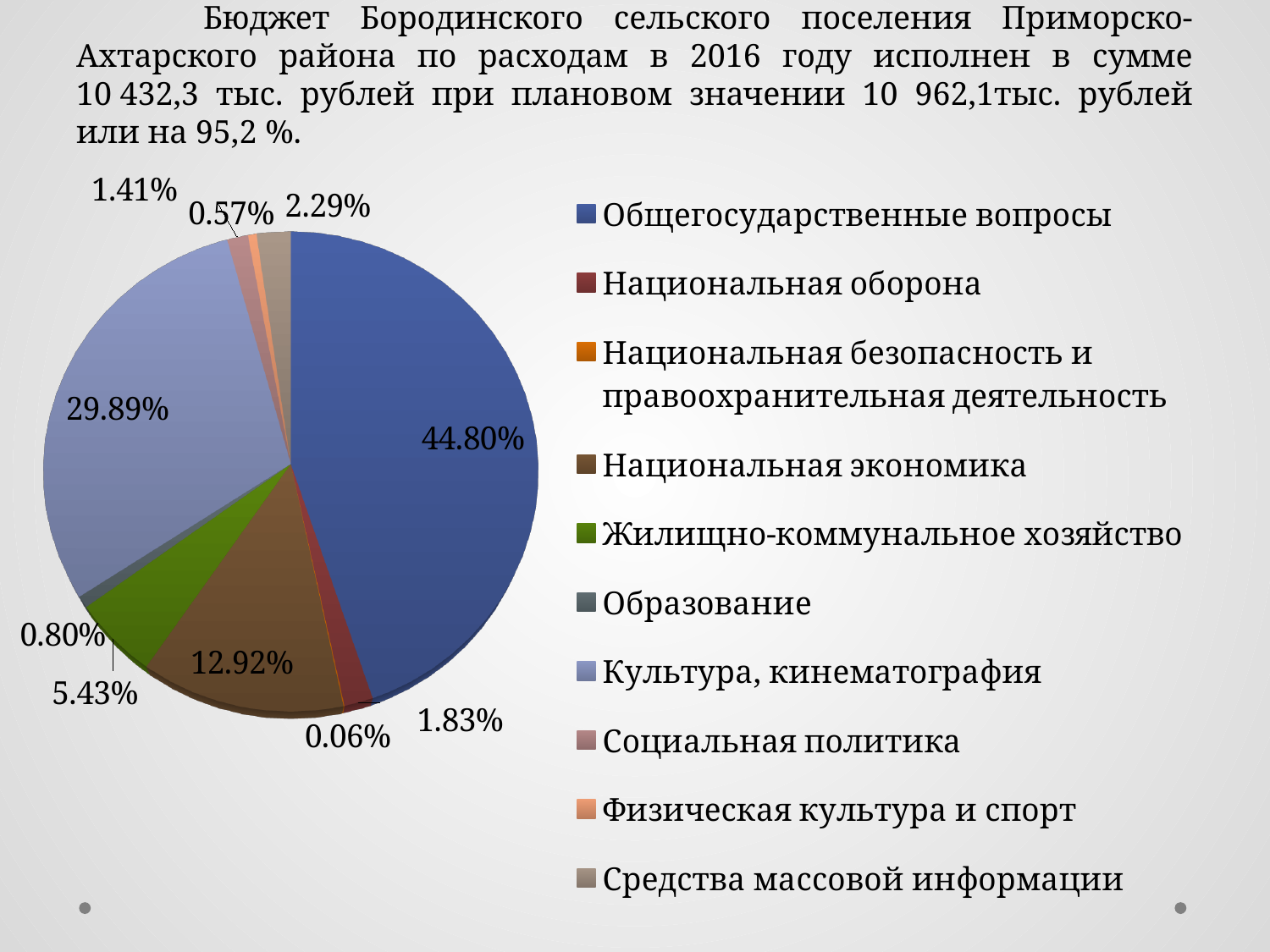
What is the value shown for Национальная экономика? 12.92% What is the difference between the shares of Общегосударственные вопросы and Культура, кинематография? 14.91% What is the value shown for Национальная оборона? 1.83% What kind of chart is shown on the slide? pie chart How many categories does the legend list? 10 Which category has the smallest slice of the pie? Национальная безопасность и правоохранительная деятельность What is the value shown for Образование? 0.80% What share of the pie does Общегосударственные вопросы take? 44.80% What is the value shown for Жилищно-коммунальное хозяйство? 5.43% What share of the pie does Культура, кинематография take? 29.89% Which is larger, the share for Социальная политика or the share for Средства массовой информации? Средства массовой информации Which category has the largest slice of the pie? Общегосударственные вопросы